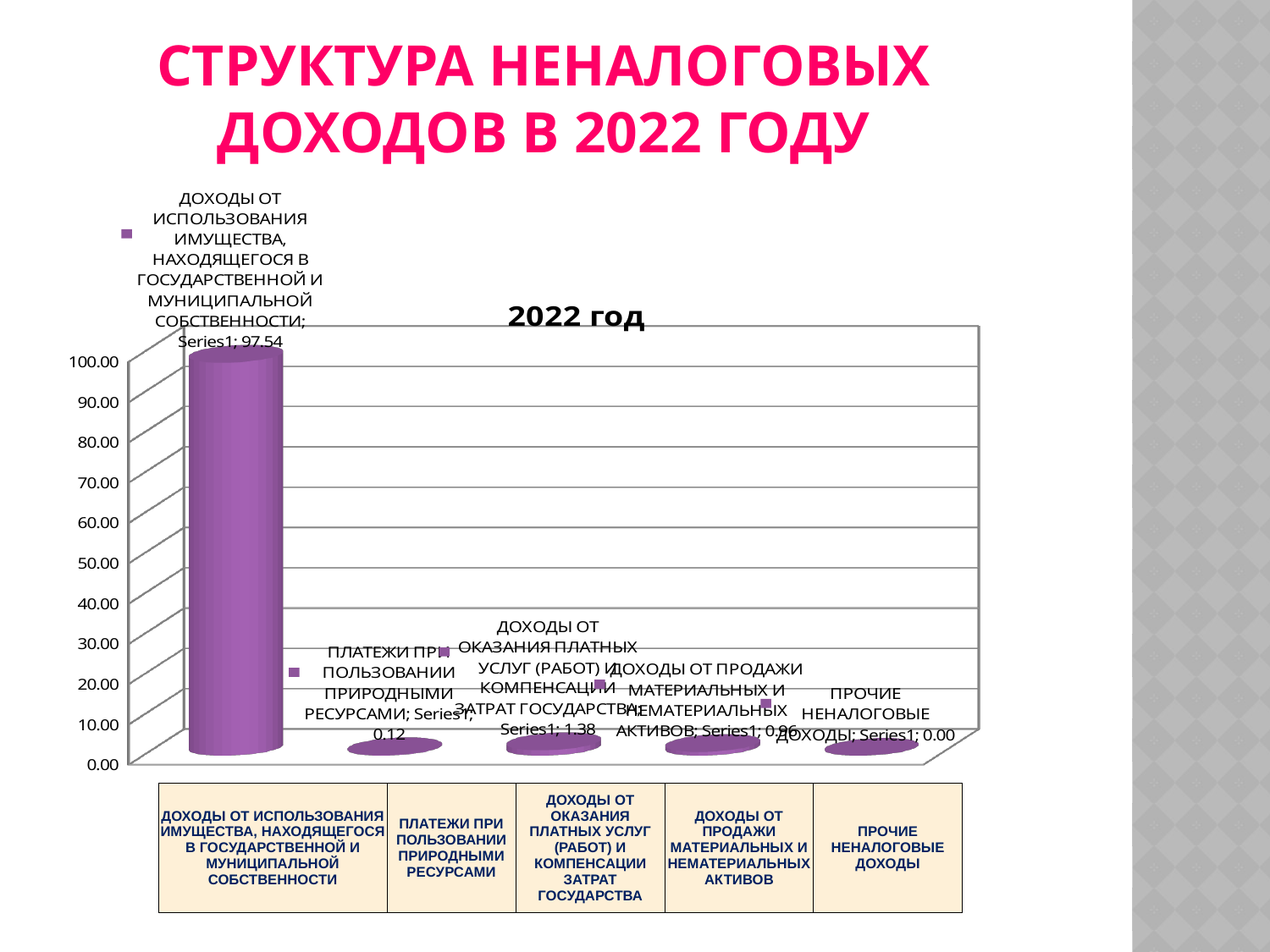
Is the value for ДОХОДЫ ОТ ИСПОЛЬЗОВАНИЯ ИМУЩЕСТВА greater or less than 90.00? greater What is the difference between the value for ДОХОДЫ ОТ ИСПОЛЬЗОВАНИЯ ИМУЩЕСТВА and the value for ДОХОДЫ ОТ ОКАЗАНИЯ ПЛАТНЫХ УСЛУГ (РАБОТ) И КОМПЕНСАЦИИ ЗАТРАТ ГОСУДАРСТВА? 96.16 How many categories are shown in the chart? 5 Which is larger: the value for ПЛАТЕЖИ ПРИ ПОЛЬЗОВАНИИ ПРИРОДНЫМИ РЕСУРСАМИ or the value for ДОХОДЫ ОТ ОКАЗАНИЯ ПЛАТНЫХ УСЛУГ (РАБОТ) И КОМПЕНСАЦИИ ЗАТРАТ ГОСУДАРСТВА? ДОХОДЫ ОТ ОКАЗАНИЯ ПЛАТНЫХ УСЛУГ (РАБОТ) И КОМПЕНСАЦИИ ЗАТРАТ ГОСУДАРСТВА What is the title of the chart? 2022 год What is the value for ПЛАТЕЖИ ПРИ ПОЛЬЗОВАНИИ ПРИРОДНЫМИ РЕСУРСАМИ? 0.12 Which category has the highest value? ДОХОДЫ ОТ ИСПОЛЬЗОВАНИЯ ИМУЩЕСТВА, НАХОДЯЩЕГОСЯ В ГОСУДАРСТВЕННОЙ И МУНИЦИПАЛЬНОЙ СОБСТВЕННОСТИ What is the value for ДОХОДЫ ОТ ИСПОЛЬЗОВАНИЯ ИМУЩЕСТВА, НАХОДЯЩЕГОСЯ В ГОСУДАРСТВЕННОЙ И МУНИЦИПАЛЬНОЙ СОБСТВЕННОСТИ? 97.54 What is the value for ДОХОДЫ ОТ ОКАЗАНИЯ ПЛАТНЫХ УСЛУГ (РАБОТ) И КОМПЕНСАЦИИ ЗАТРАТ ГОСУДАРСТВА? 1.38 What is the value for ПРОЧИЕ НЕНАЛОГОВЫЕ ДОХОДЫ? 0.00 Which category has the lowest value? ПРОЧИЕ НЕНАЛОГОВЫЕ ДОХОДЫ What kind of chart is shown on the slide? bar chart